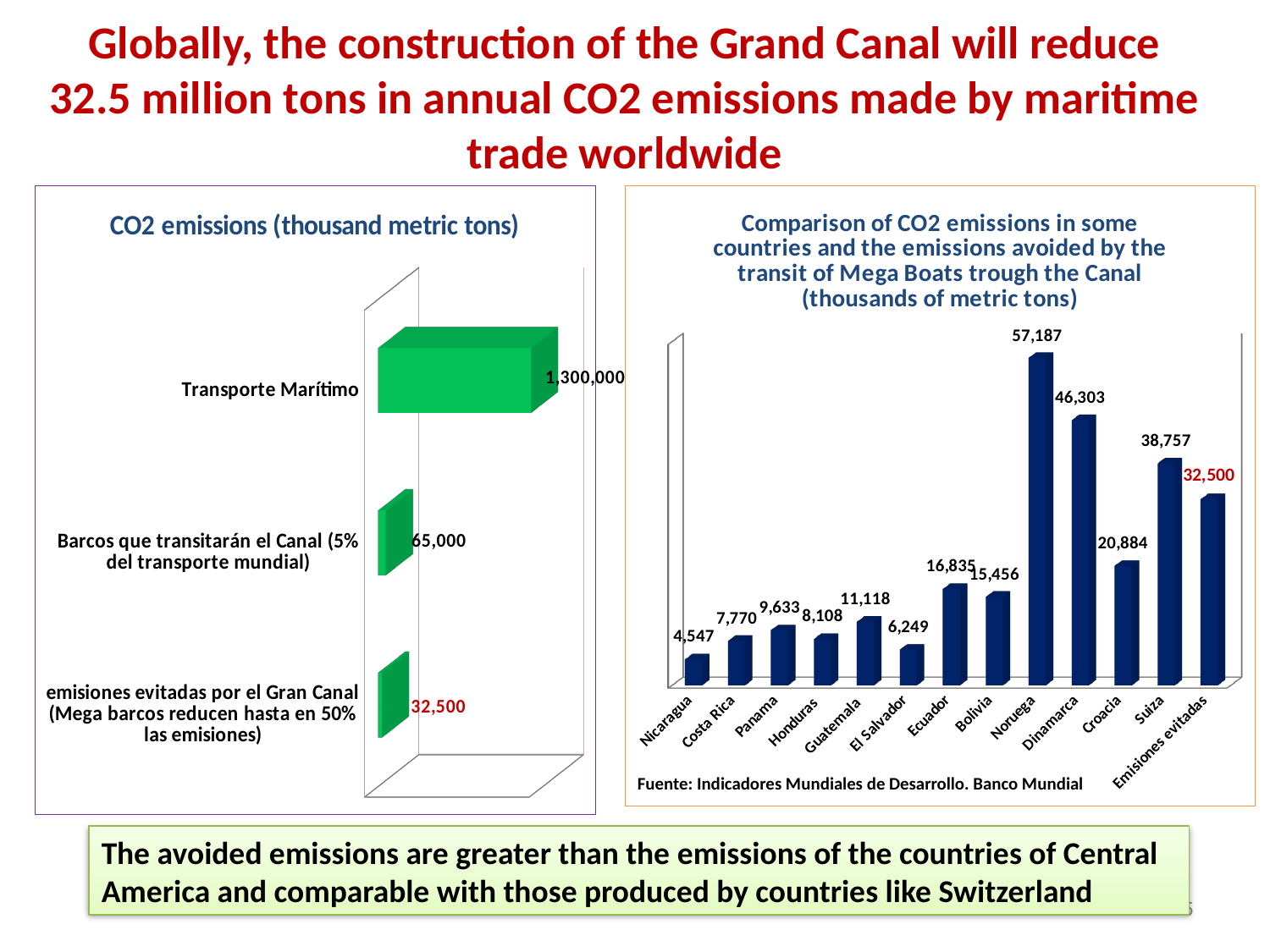
What kind of chart is the right chart comparing CO2 emissions in some countries? Bar chart In the left chart 'CO2 emissions (thousand metric tons)', what is the difference between Transporte Marítimo and 'Barcos que transitarán el Canal'? 1,235,000 In the left chart 'CO2 emissions (thousand metric tons)', what is the value for Transporte Marítimo? 1,300,000 In the right chart comparing CO2 emissions in some countries, which is larger: Ecuador or Bolivia? Ecuador In the left chart 'CO2 emissions (thousand metric tons)', how many categories are plotted? 3 In the right chart comparing CO2 emissions in some countries, how many categories are plotted? 13 In the right chart comparing CO2 emissions in some countries, what is the value for Suiza? 38,757 In the right chart comparing CO2 emissions in some countries, which category has the lowest value? Nicaragua In the right chart comparing CO2 emissions in some countries, which category has the highest value? Noruega In the right chart comparing CO2 emissions in some countries, what is the difference between Suiza and Emisiones evitadas? 6,257 In the right chart comparing CO2 emissions in some countries, what is the value for Noruega? 57,187 In the left chart 'CO2 emissions (thousand metric tons)', what is the value for 'Barcos que transitarán el Canal'? 65,000